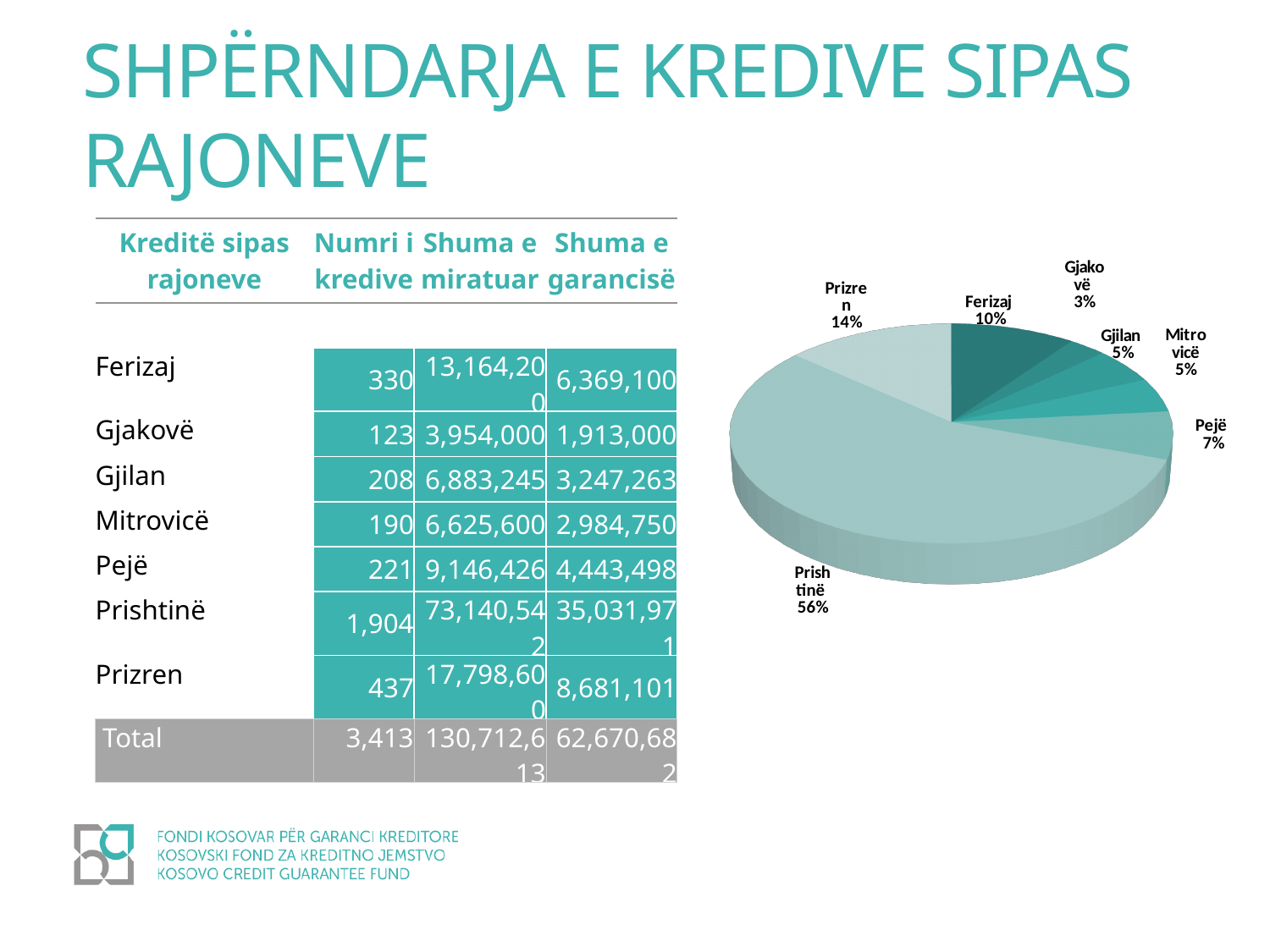
In the pie chart, what share does Gjilan have? 5% How many slices does the pie chart have? 7 In the pie chart, what share does Prishtinë have? 56% In the pie chart, what share does Ferizaj have? 10% In the pie chart, which slice is larger, Prizren or Ferizaj? Prizren In the pie chart, how many percentage points larger is Prizren's share than Ferizaj's share? 4 What kind of chart is shown on the right of the slide? pie chart Which region has the smallest slice in the pie chart? Gjakovë Which region has the largest slice in the pie chart? Prishtinë